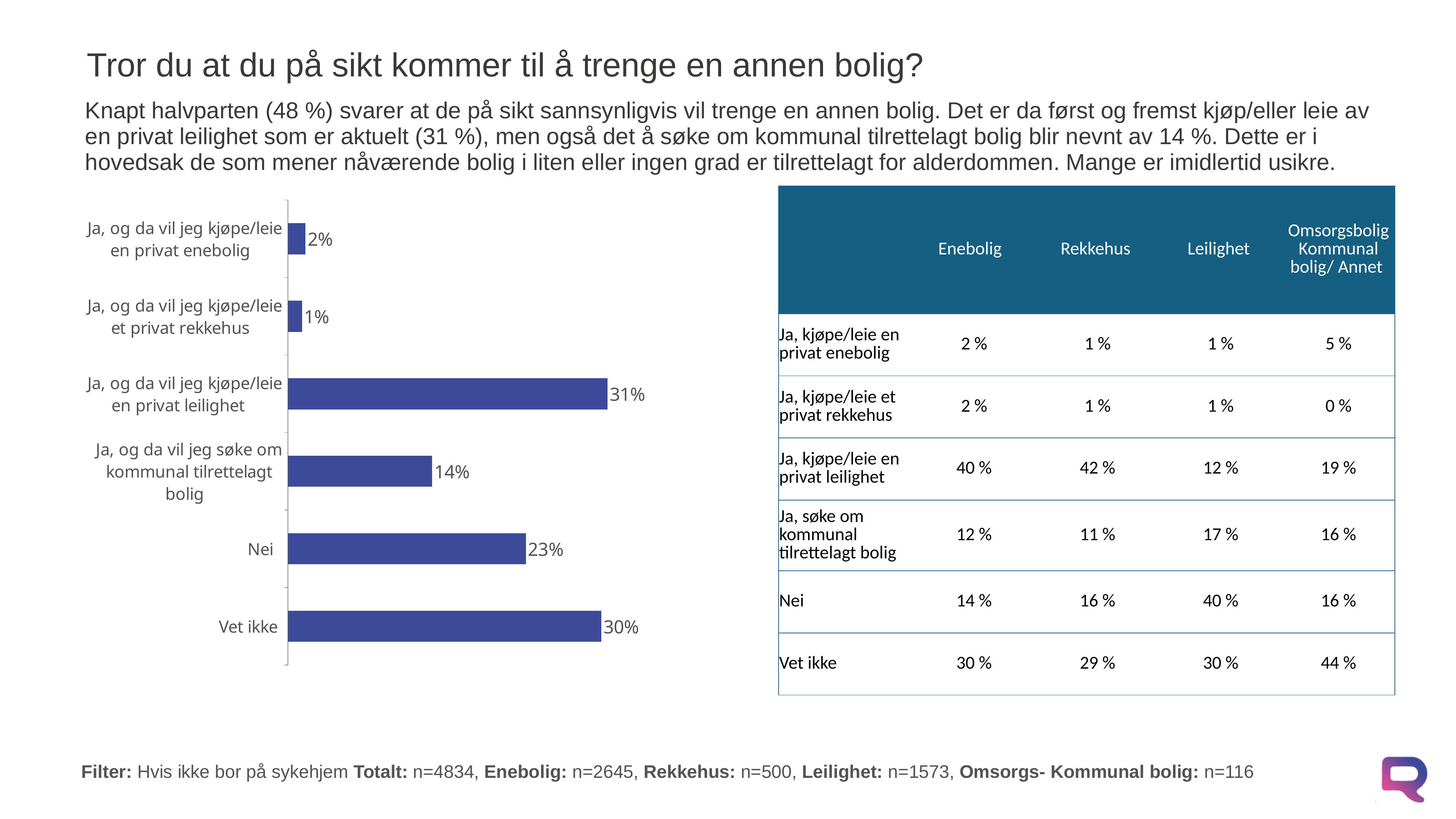
Which category has the highest value in the bar chart? Ja, og da vil jeg kjøpe/leie en privat leilighet Which category has the lowest value in the bar chart? Ja, og da vil jeg kjøpe/leie et privat rekkehus What colour are the bars in the chart? Blue What value is shown for "Ja, og da vil jeg kjøpe/leie en privat leilighet"? 31% What type of chart is shown on the slide? Bar chart What percentage of respondents answered "Vet ikke" in the bar chart? 30% How many categories are shown in the bar chart? 6 Which is larger: the value for "Nei" or the value for "Vet ikke"? Vet ikke What percentage answered "Nei"? 23% What is the difference between the value for "Vet ikke" and the value for "Nei"? 7% What is the difference between "Ja, og da vil jeg kjøpe/leie en privat leilighet" and "Ja, og da vil jeg søke om kommunal tilrettelagt bolig"? 17% What value is shown for "Ja, og da vil jeg søke om kommunal tilrettelagt bolig"? 14%